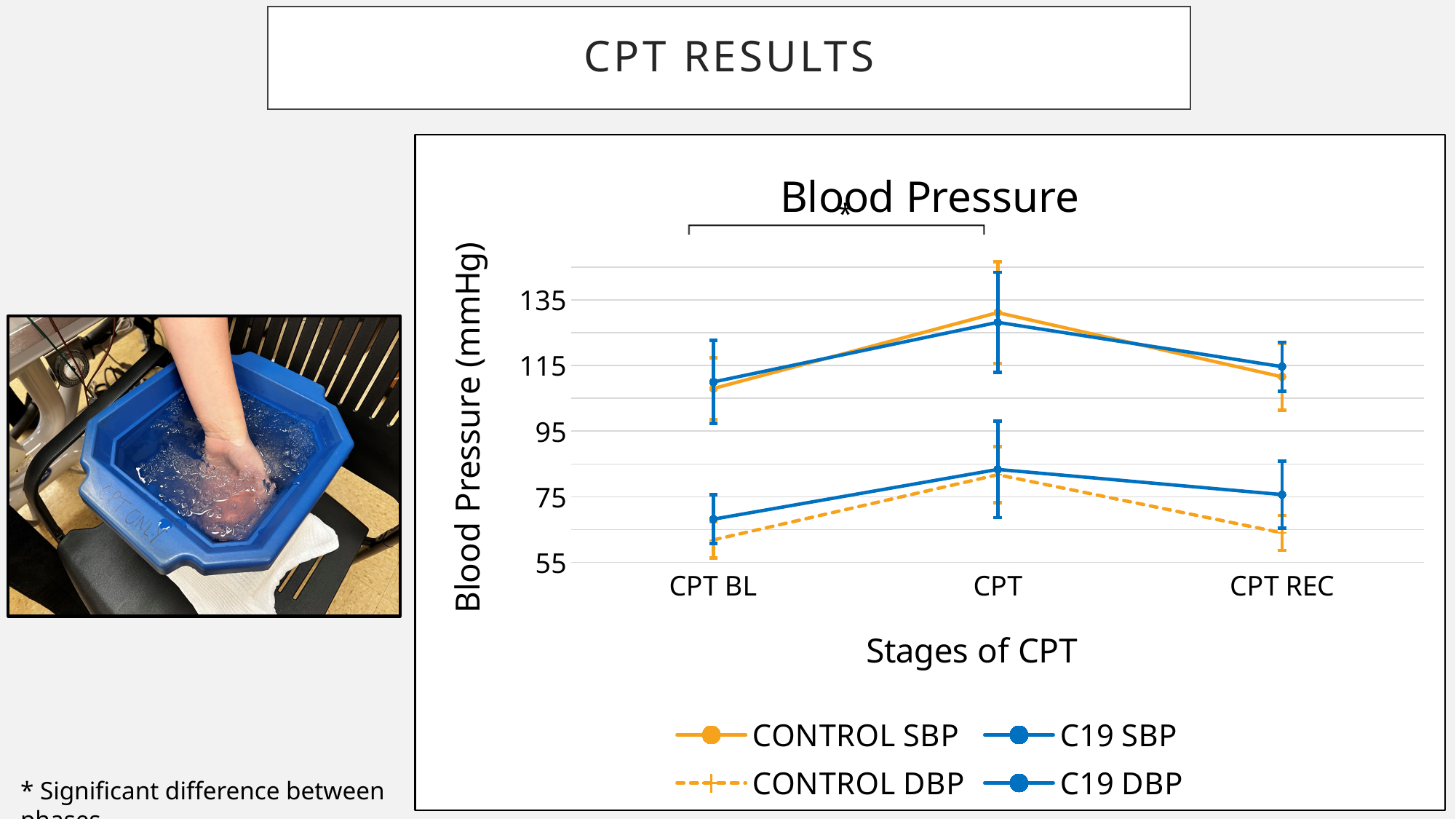
What is the label of the y axis? Blood Pressure (mmHg) Is the value for C19 DBP at CPT BL greater or less than 75? less How many stages of CPT are plotted along the x axis? 3 Does CONTROL SBP rise or fall from CPT BL to CPT? rise At which stage is CONTROL SBP highest? CPT How many series does the legend list? 4 What is the title of the chart? Blood Pressure What kind of chart is shown on the slide? line chart Is the value for C19 DBP at CPT greater or less than 75? greater Is the value for CONTROL DBP at CPT REC greater or less than 75? less At CPT REC, which is larger: C19 DBP or CONTROL DBP? C19 DBP